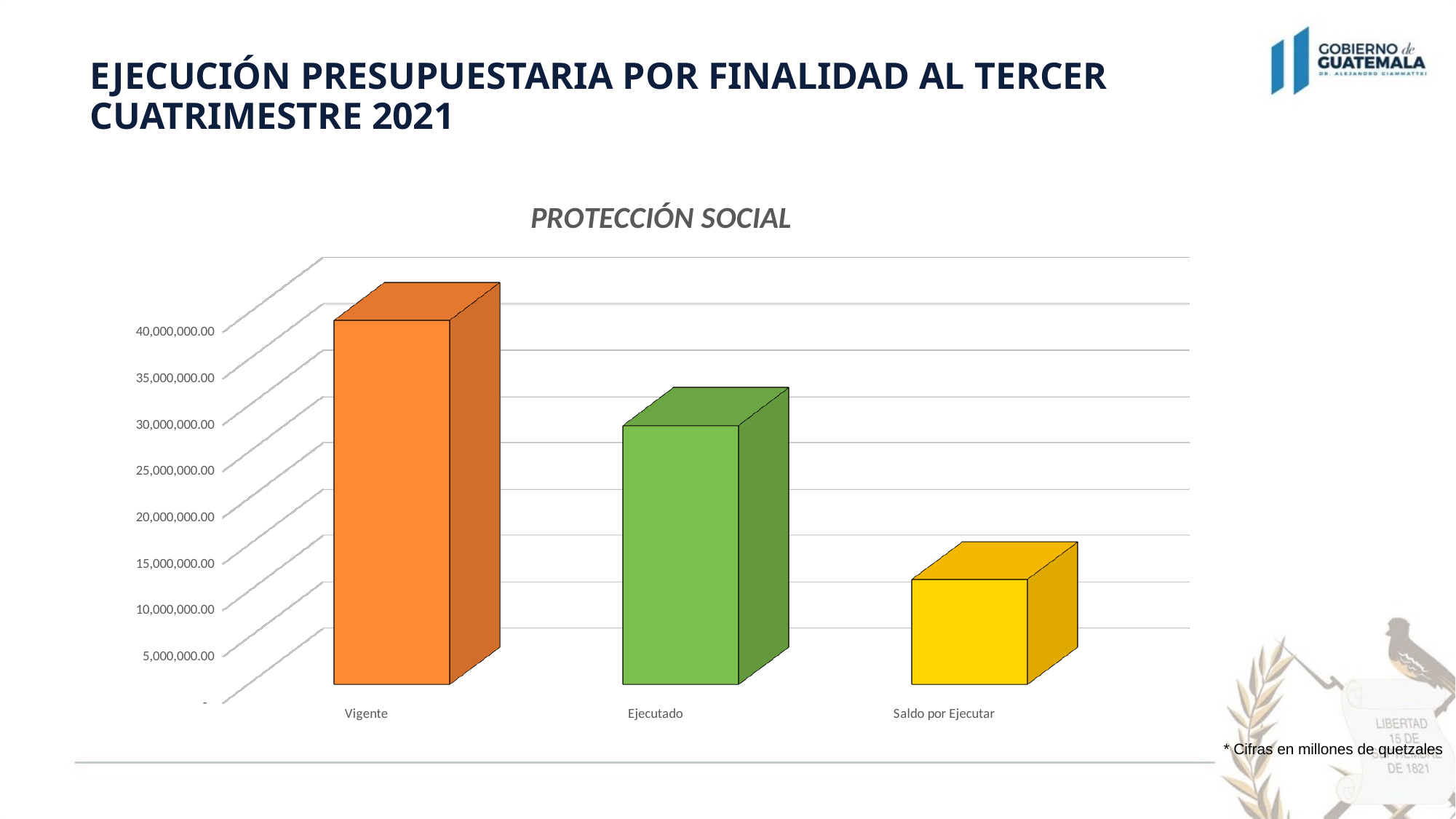
What kind of chart is shown on the slide? bar chart Is the value for Vigente greater or less than 35,000,000.00? greater Do the values rise or fall from left to right across the categories? fall What colour is the bar for Vigente? orange Which category has the lowest value? Saldo por Ejecutar Which is larger, the value for Ejecutado or the value for Saldo por Ejecutar? Ejecutado Is the value for Saldo por Ejecutar greater or less than 15,000,000.00? less Which is larger, the value for Vigente or the value for Ejecutado? Vigente Which category has the highest value? Vigente Is the value for Ejecutado greater or less than 25,000,000.00? greater How many categories are plotted in the chart? 3 What is the title of the chart? PROTECCIÓN SOCIAL